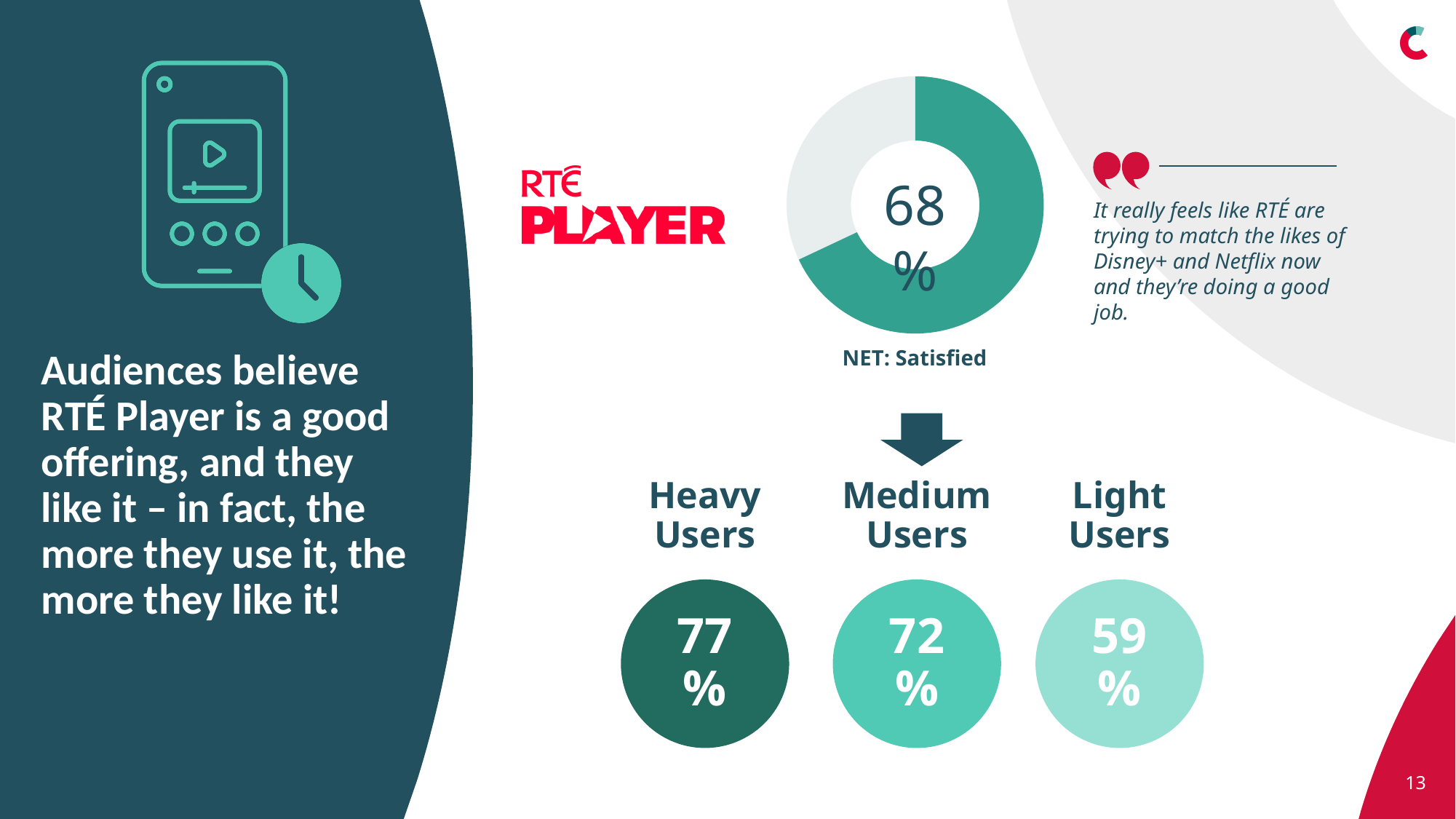
Among the user groups shown below the donut chart, which has the lowest value? Light Users Among the user groups shown below the donut chart, which has the highest value? Heavy Users What kind of chart is used to show the NET: Satisfied figure? donut (pie) chart In the circles below the donut chart, what is the value for Heavy Users? 77% How many user groups are shown in the circles below the donut chart? 3 Is the NET: Satisfied value in the donut chart greater or less than 50%? greater In the donut chart, which segment is larger, the teal segment or the light grey segment? the teal segment What is the difference between the Heavy Users value and the Light Users value shown below the donut chart? 18 percentage points In the circles below the donut chart, what is the value for Medium Users? 72% What value is printed in the centre of the donut chart? 68% What label appears directly below the donut chart? NET: Satisfied In the circles below the donut chart, what is the value for Light Users? 59%